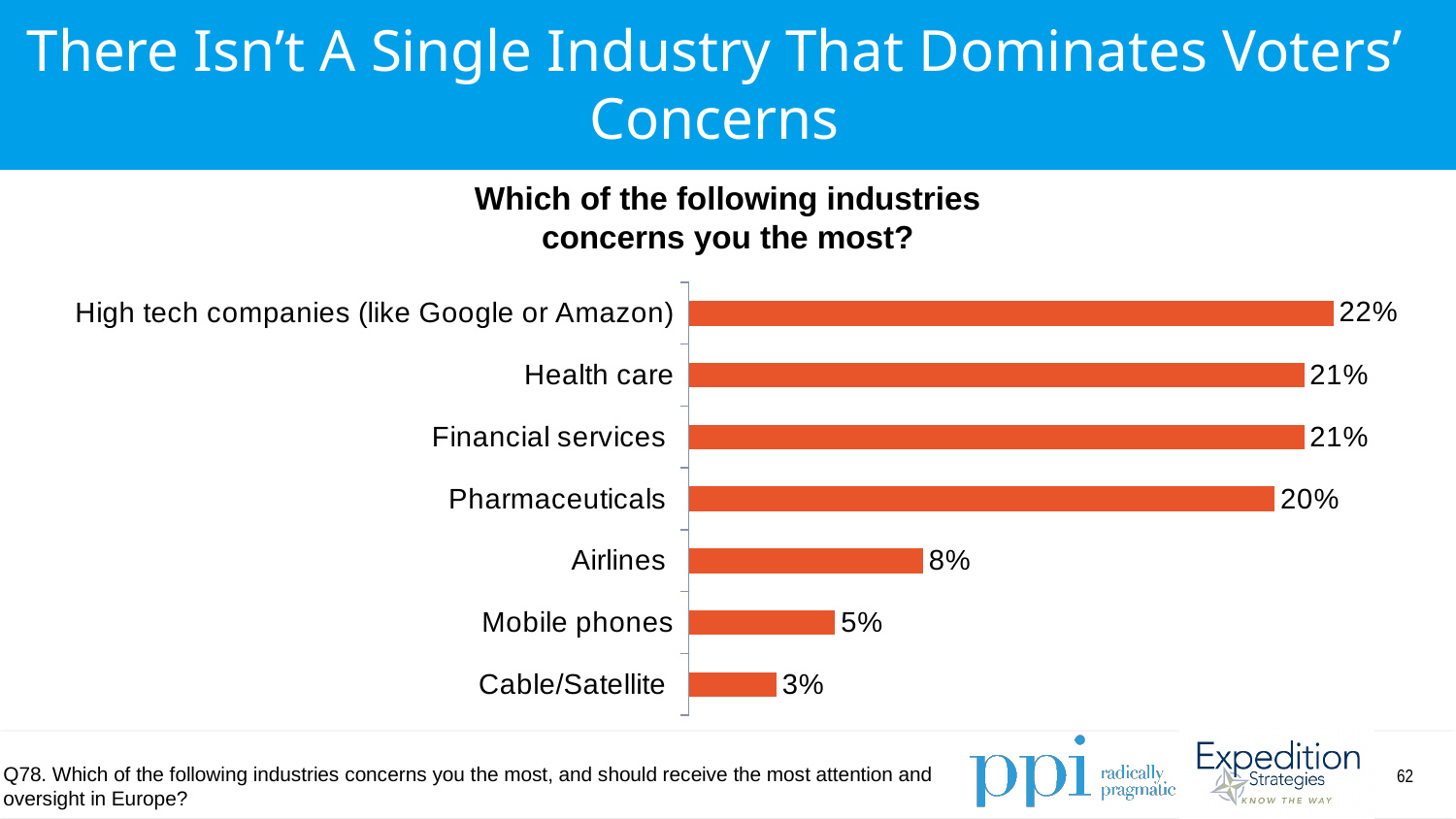
What is the value shown for Pharmaceuticals? 20% Which industry has the highest value in the chart? High tech companies (like Google or Amazon) What is the value shown for Cable/Satellite? 3% What percentage of voters said high tech companies (like Google or Amazon) concern them the most? 22% What kind of chart is shown on the slide? Bar chart What is the difference between the values for High tech companies and Cable/Satellite? 19% What is the title of the chart? Which of the following industries concerns you the most? Which industry has the lowest value in the chart? Cable/Satellite What is the difference between the values for Airlines and Mobile phones? 3% How many industries are shown in the chart? 7 Which has a larger value, Pharmaceuticals or Airlines? Pharmaceuticals What is the value shown for Airlines? 8%